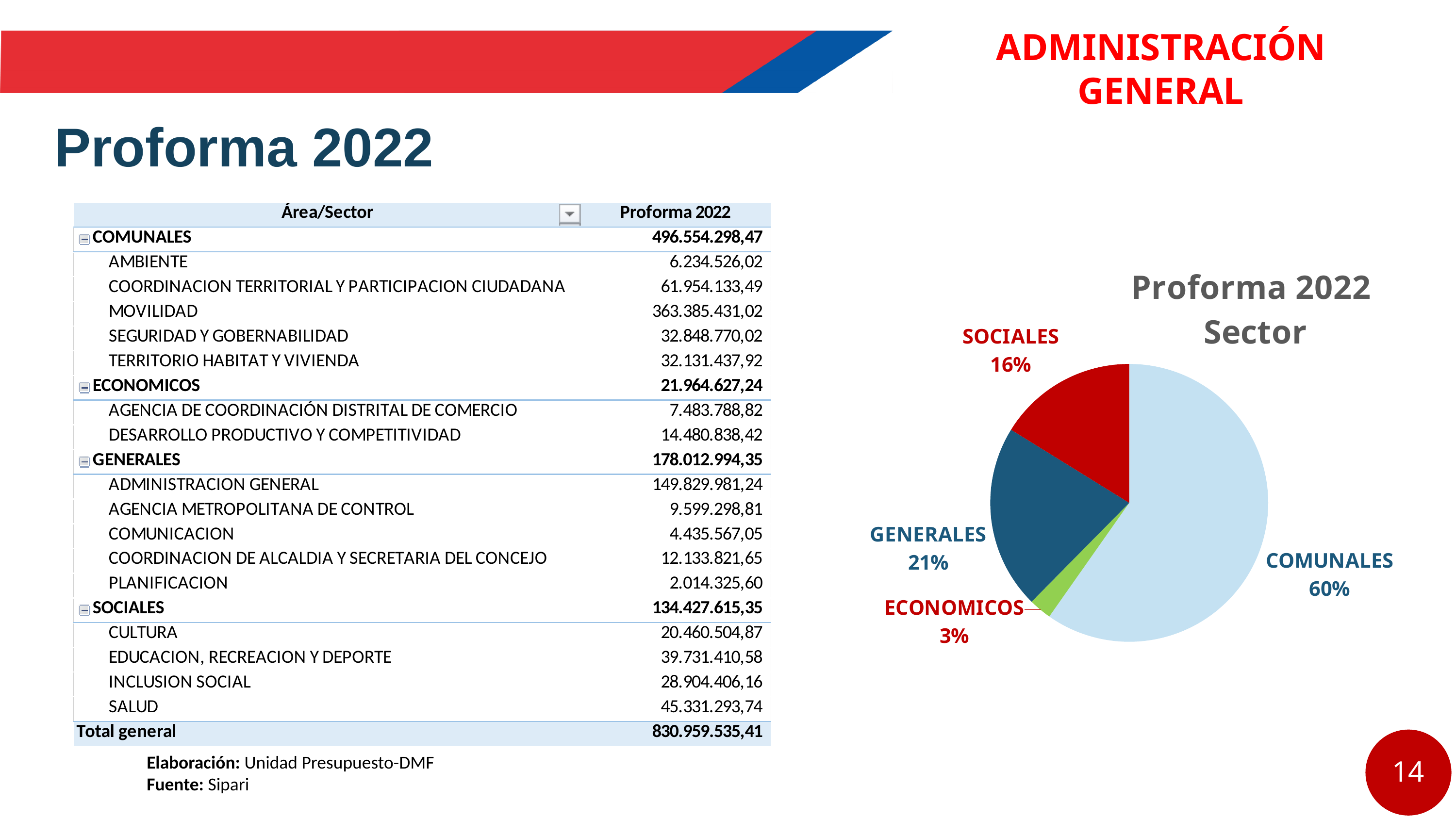
What share of the pie chart does GENERALES represent? 21% What share of the pie chart does SOCIALES represent? 16% Which sector has the largest slice in the pie chart? COMUNALES In the pie chart, what is the difference in percentage points between COMUNALES and GENERALES? 39 What is the title of the pie chart? Proforma 2022 Sector In the pie chart, which is larger, GENERALES or SOCIALES? GENERALES In the pie chart, what colour is the COMUNALES slice? light blue What share of the pie chart does COMUNALES represent? 60% Which sector has the smallest slice in the pie chart? ECONOMICOS How many slices does the pie chart have? 4 What type of chart is shown on the slide? pie chart